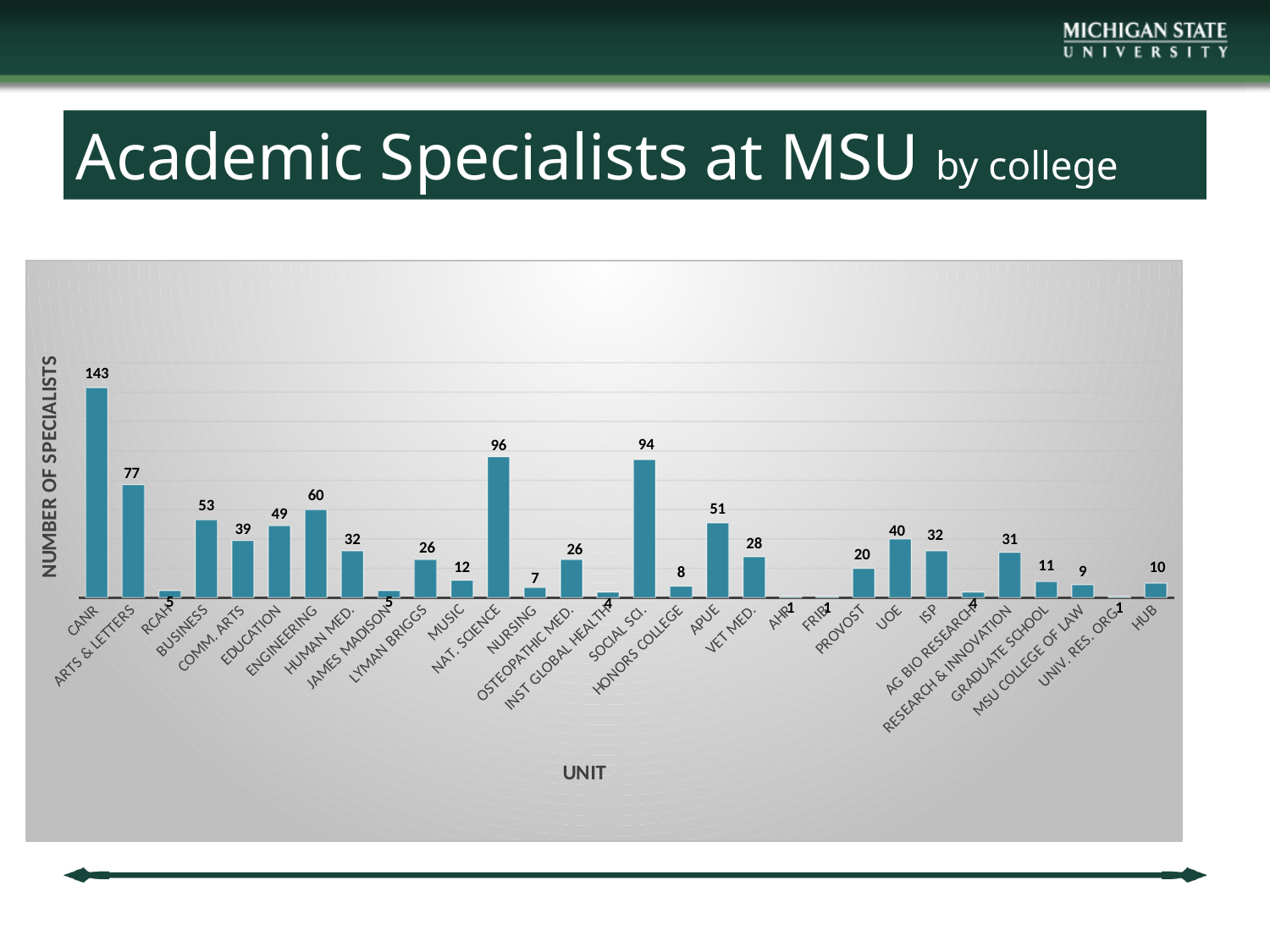
What is the value for PROVOST? 20 How many academic specialists does CANR have? 143 Which has more specialists, BUSINESS or APUE? BUSINESS Which has more specialists, UOE or ISP? UOE Which unit has the highest number of specialists? CANR What is the number of specialists for NAT. SCIENCE? 96 How many specialists are shown for ENGINEERING? 60 What is the difference between the values for NAT. SCIENCE and SOCIAL SCI.? 2 How many units are shown on the x axis? 30 What is the difference between the values for CANR and ARTS & LETTERS? 66 What type of chart is shown on the slide? Bar chart What is the value shown for SOCIAL SCI.? 94